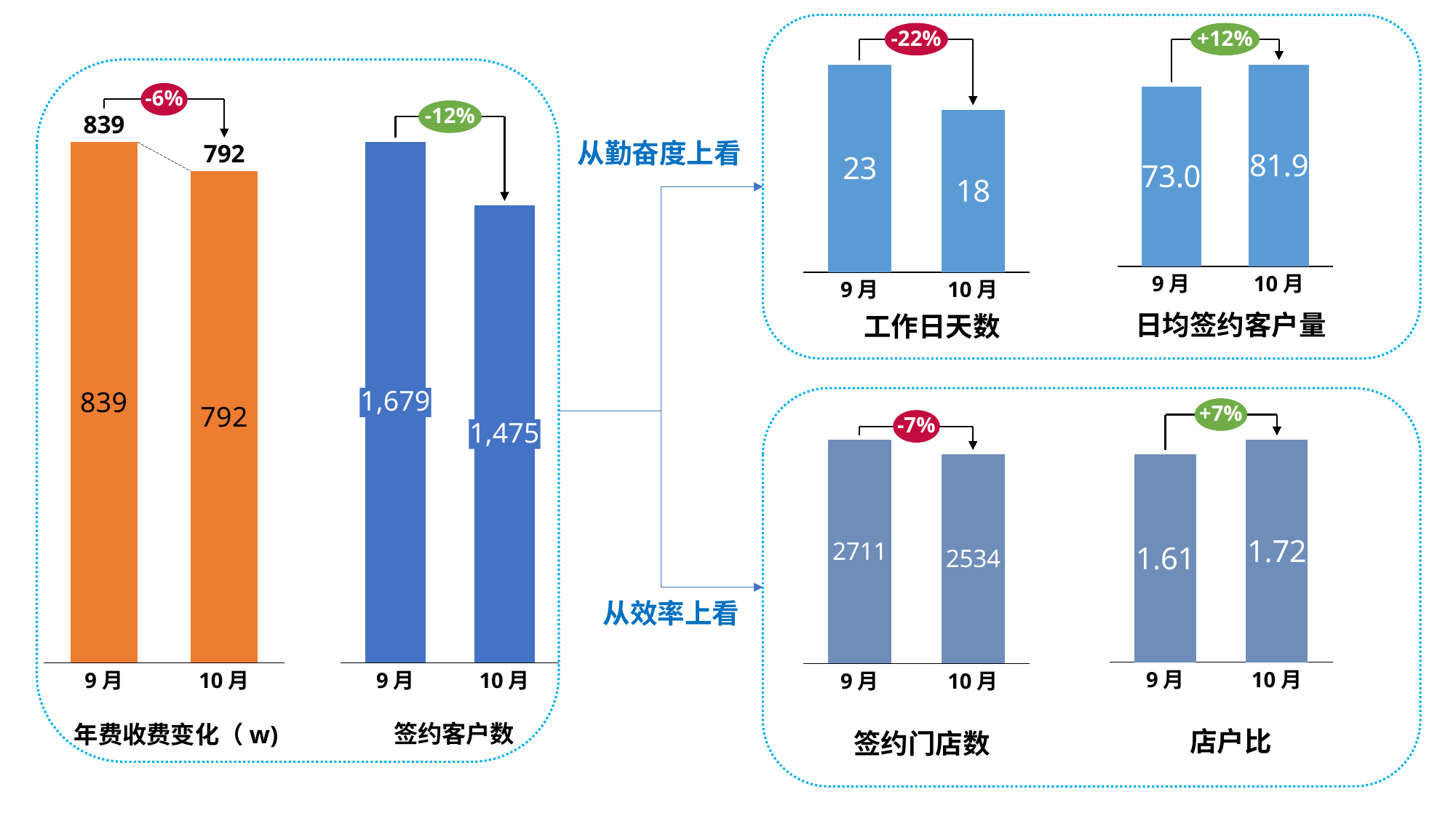
In the 日均签约客户量 chart, do the values rise or fall from 9月 to 10月? rise In the 签约客户数 chart, what is the difference between the 9月 and 10月 values? 204 In the 日均签约客户量 chart, what is the value for 10月? 81.9 In the 工作日天数 chart, what is the value for 10月? 18 In the 年费收费变化（w） chart, what is the value for 10月? 792 In the 工作日天数 chart, is the value for 9月 larger or smaller than the value for 10月? larger In the 签约门店数 chart, what is the value for 9月? 2711 How many bars does the 签约门店数 chart have? 2 In the 店户比 chart, which month has the higher value? 10月 In the 年费收费变化（w） chart, what is the difference between the 9月 and 10月 values? 47 What type of chart is the 店户比 chart? bar chart In the 签约客户数 chart, what is the value for 9月? 1,679